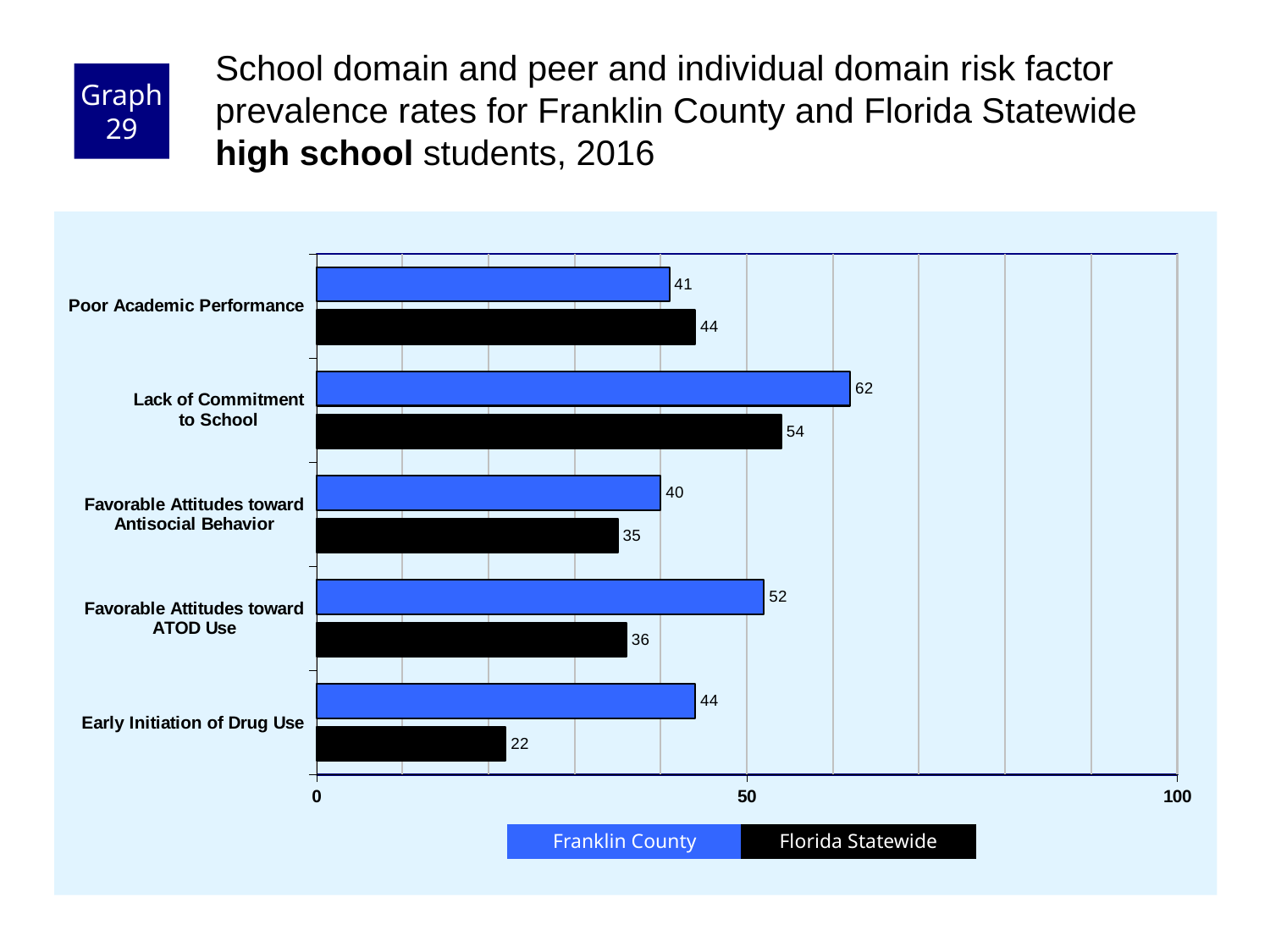
How many series does the legend list? 2 What is the difference between the Franklin County and Florida Statewide values for Favorable Attitudes toward ATOD Use? 16 How many risk factors are shown on the chart? 5 What is the Franklin County value for Lack of Commitment to School? 62 What is the Florida Statewide value for Poor Academic Performance? 44 What is the Florida Statewide value for Early Initiation of Drug Use? 22 For Poor Academic Performance, which is larger: the Franklin County value or the Florida Statewide value? Florida Statewide Which risk factor has the highest Franklin County value? Lack of Commitment to School Which colour represents Florida Statewide in the chart? black Is the Franklin County value for Lack of Commitment to School greater or less than 50? greater What kind of chart is shown on the slide? bar chart Which risk factor has the lowest Florida Statewide value? Early Initiation of Drug Use